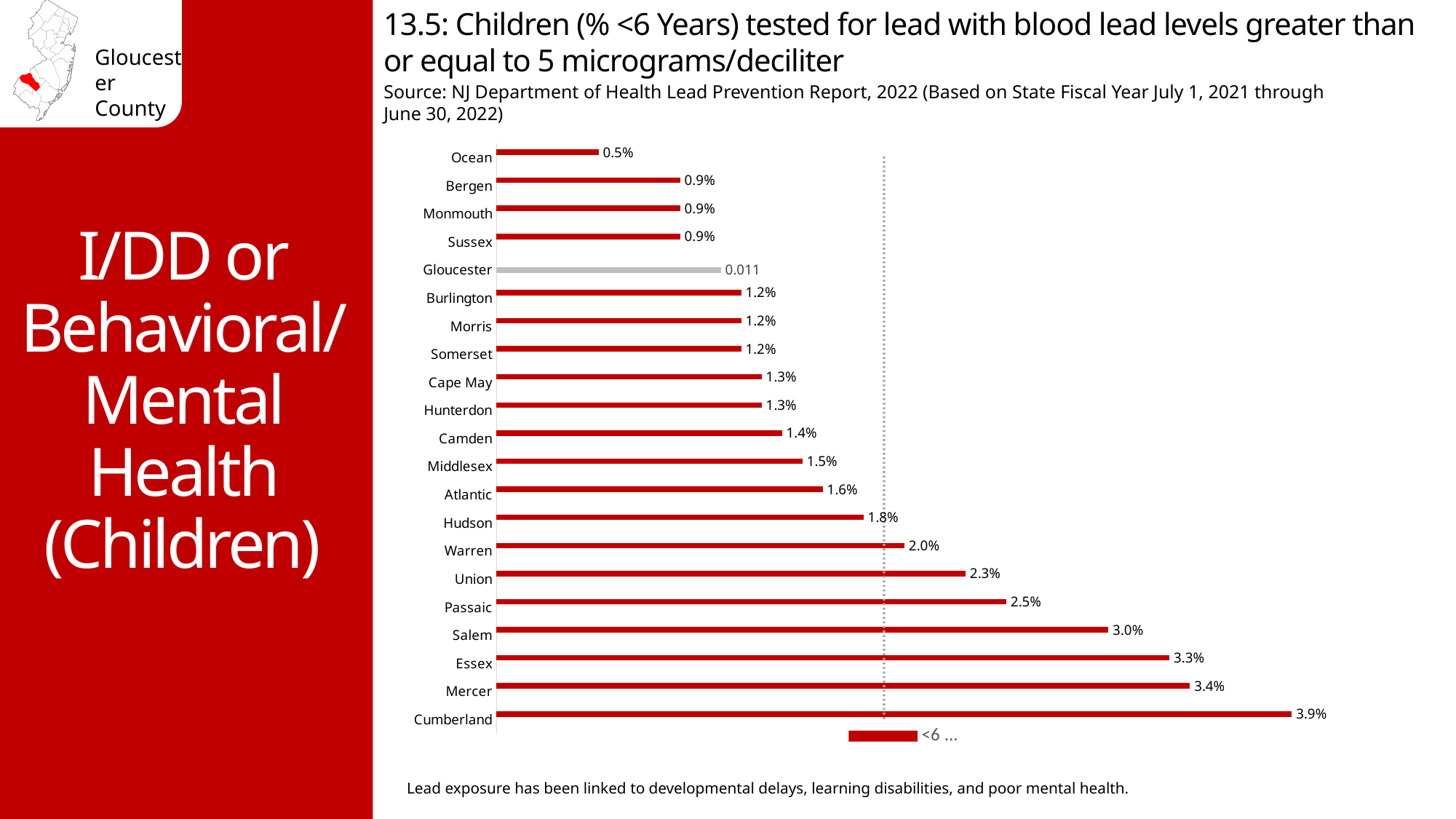
What is the value shown for Salem? 3.0% What kind of chart is shown on the slide? Bar chart How many counties are plotted in the chart? 21 Do the bar values increase or decrease going from the top of the chart (Ocean) to the bottom (Cumberland)? Increase Which county's bar is drawn in grey rather than red? Gloucester Which county has the lowest percentage of children with elevated blood lead levels? Ocean What is the difference between the values for Cumberland and Ocean? 3.4 percentage points Which has a higher value, Hudson or Atlantic? Hudson What is the value shown for Camden? 1.4% Which county has the highest percentage of children with elevated blood lead levels? Cumberland What label is printed next to the Gloucester bar? 0.011 What is the difference between the values for Mercer and Essex? 0.1 percentage points